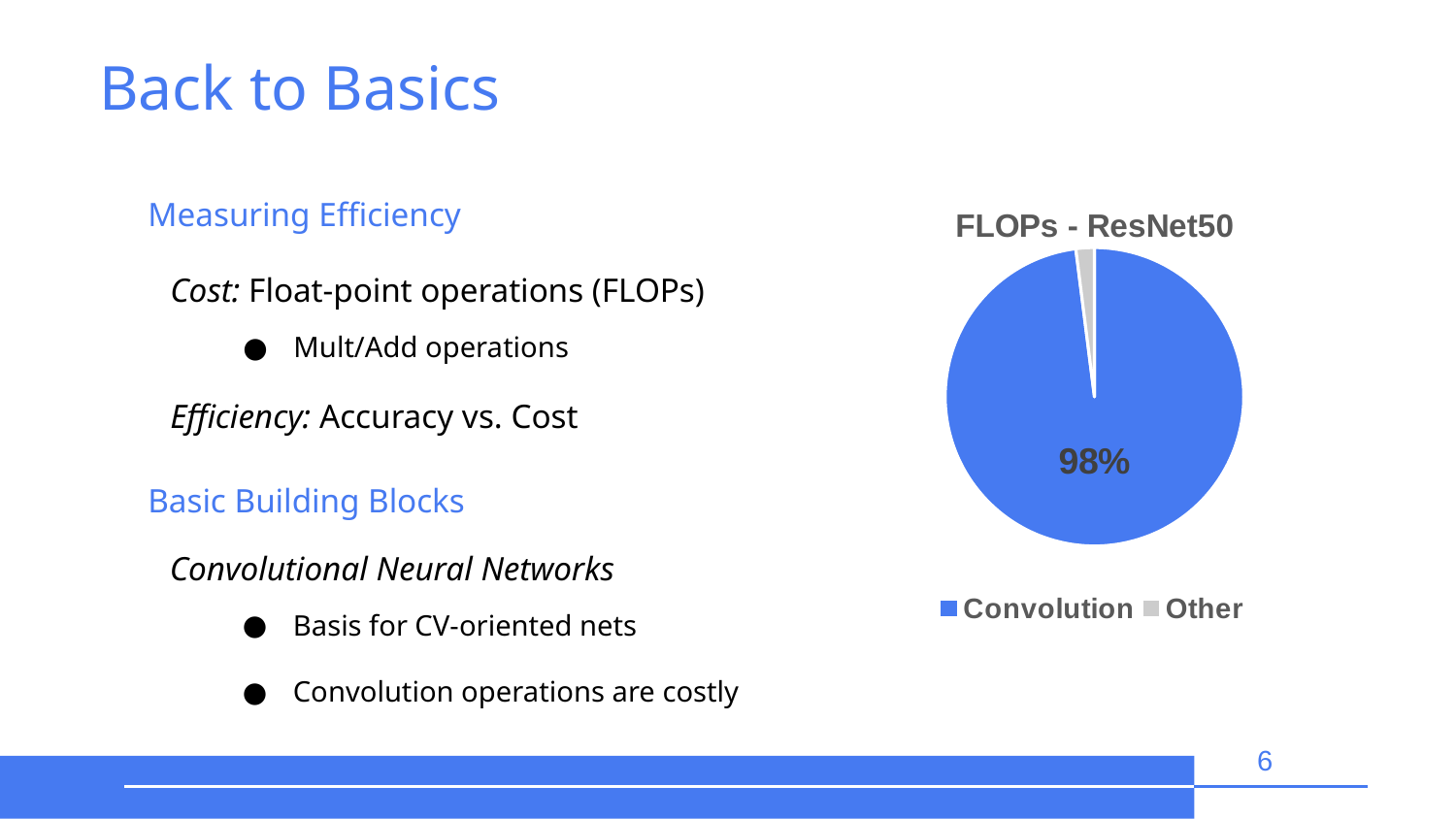
What share of the pie does Convolution take? 98% Which slice of the pie is the largest? Convolution How many entries does the legend list? 2 Which is larger, the Convolution slice or the Other slice? Convolution How many slices does the pie chart have? 2 What is the title of the pie chart? FLOPs - ResNet50 Which slice of the pie is the smallest? Other What colour is the Convolution slice? blue Is the share for Convolution greater or less than 50%? greater What kind of chart is shown on the slide? pie chart